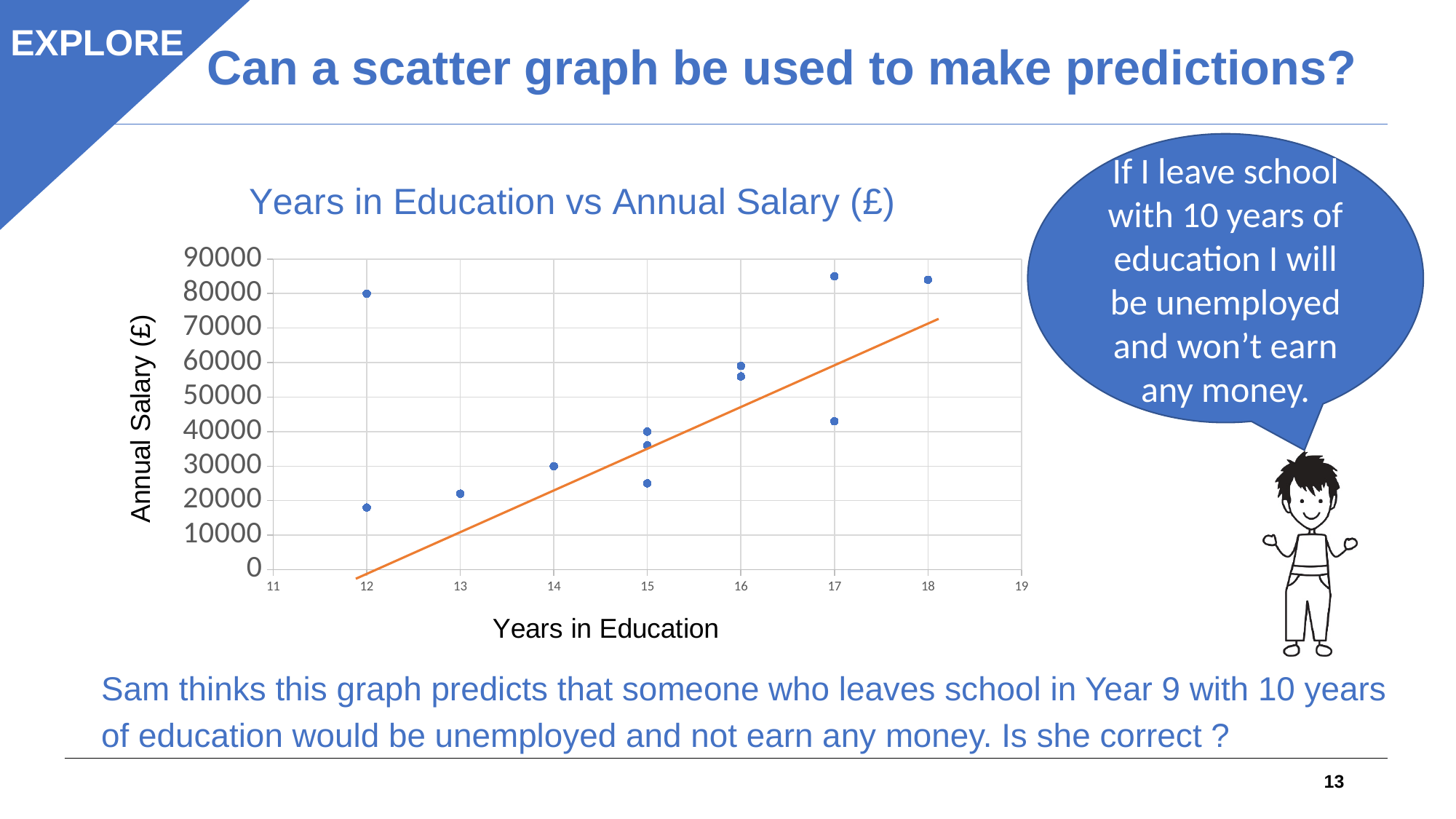
What kind of chart is shown on the slide? Scatter graph What is the higher of the two annual salaries plotted at 12 years in education? 80000 Which has the higher plotted annual salary: 13 years in education or 14 years in education? 14 years in education What annual salary is plotted for 14 years in education? 30000 At how many years in education is the lowest plotted annual salary found? 12 How many data points are plotted on the scatter graph? 12 Overall, does annual salary rise or fall as years in education increase along the x axis? Rise Is the annual salary plotted for 18 years in education greater or less than 80000? greater How many data points are plotted at 15 years in education? 3 Is the annual salary plotted for 13 years in education greater or less than 30000? less What is the title of the chart? Years in Education vs Annual Salary (£) What colour is the trend line drawn on the scatter graph? Orange